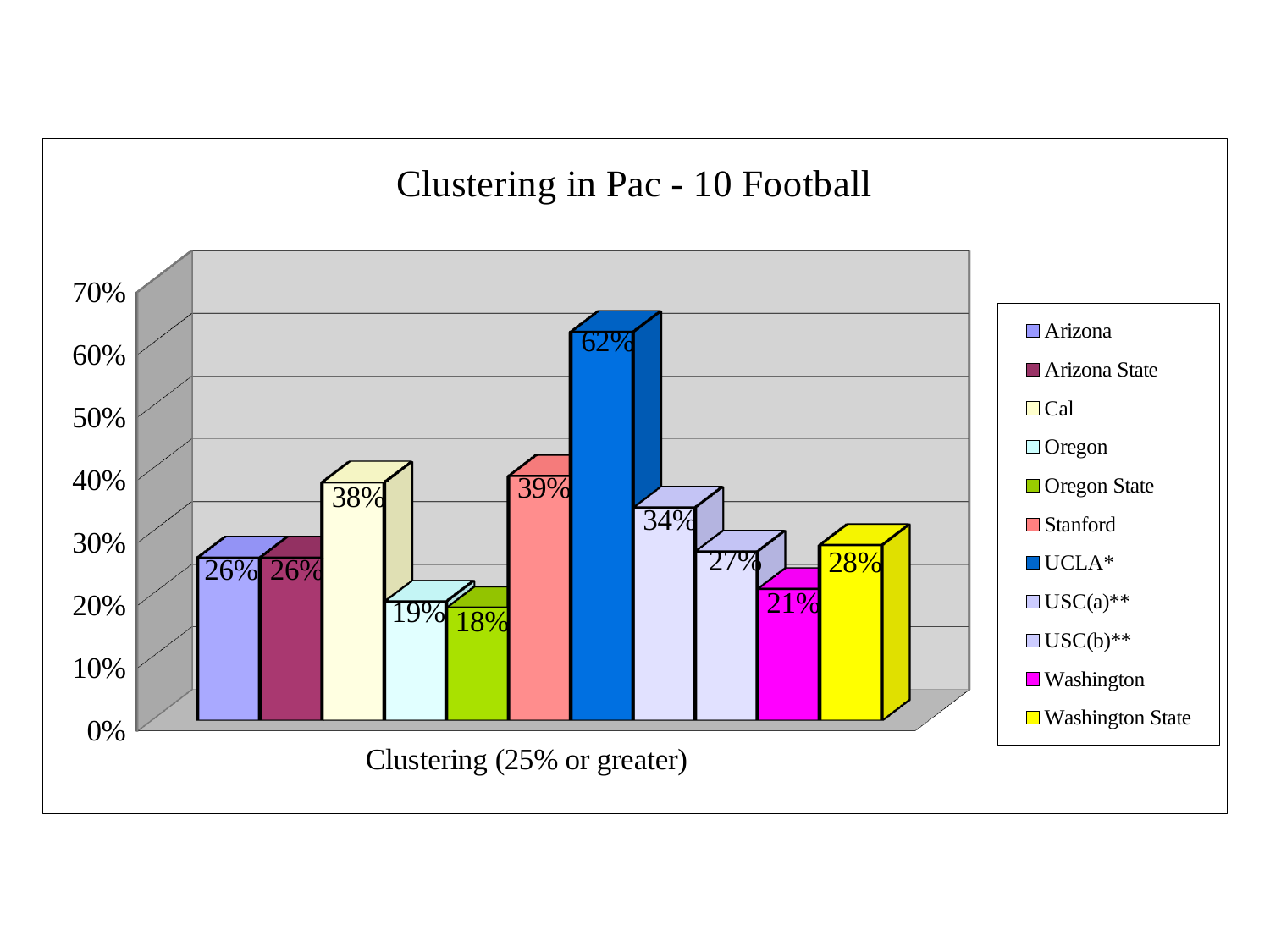
Which team has the lowest clustering value? Oregon State Which team has the highest clustering value? UCLA* What is the value for Stanford in the chart? 39% What is the difference between the values for UCLA* and Stanford? 23% Is the value for Washington State greater or less than 20%? greater What is the value for UCLA* in the chart? 62% What is the title of the chart? Clustering in Pac - 10 Football How many series does the legend list? 11 Which is larger, the value for Cal or the value for USC(a)**? Cal What is the x-axis label of the chart? Clustering (25% or greater) What kind of chart is shown on the slide? bar chart What is the value for Oregon State in the chart? 18%